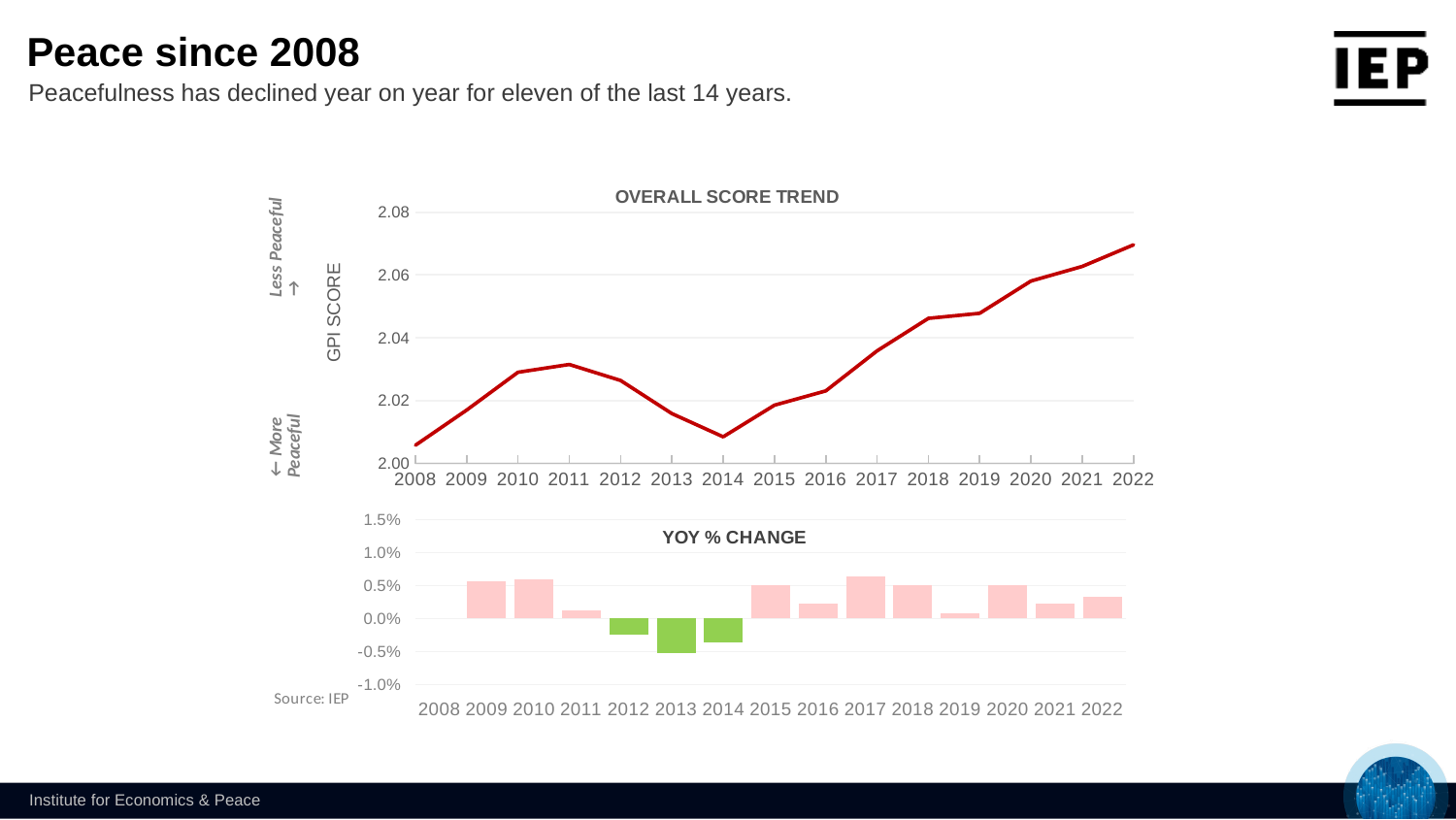
In the OVERALL SCORE TREND chart, is the value for 2018 greater or less than 2.04? greater What kind of chart is the YOY % CHANGE chart? bar chart In the OVERALL SCORE TREND chart, do the values rise or fall from 2014 to 2022? rise In the YOY % CHANGE chart, is the value for 2013 greater or less than 0.0%? less In the YOY % CHANGE chart, which is larger, the value for 2013 or the value for 2015? 2015 In the YOY % CHANGE chart, which year has the lowest value? 2013 In the OVERALL SCORE TREND chart, which is larger, the value for 2008 or the value for 2022? 2022 What kind of chart is the OVERALL SCORE TREND chart? line chart In the OVERALL SCORE TREND chart, which year has the highest GPI score? 2022 In the OVERALL SCORE TREND chart, is the value for 2022 greater or less than 2.06? greater How many years are shown on the x axis of the OVERALL SCORE TREND chart? 15